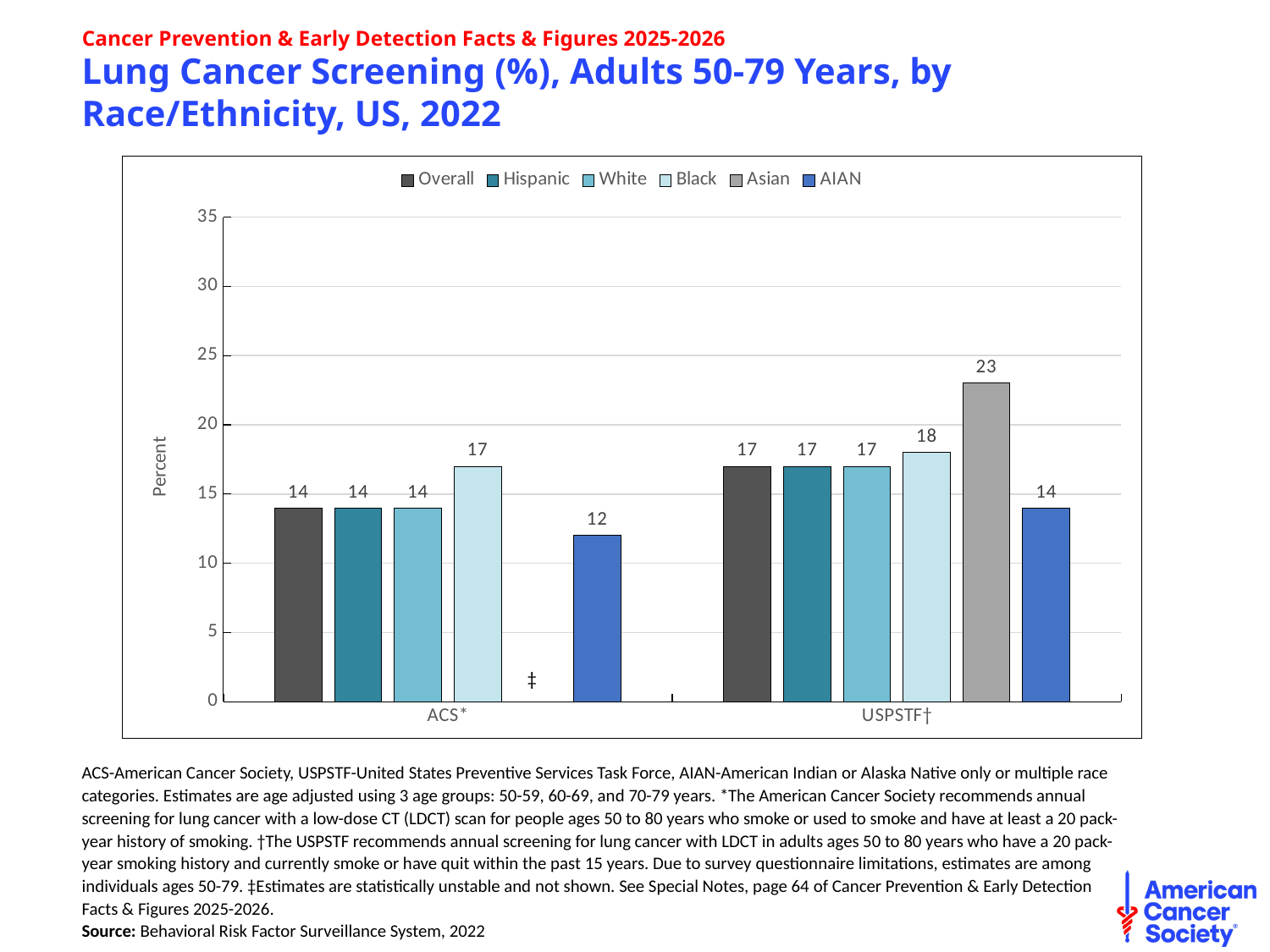
How many series does the legend list? 6 What is the label on the vertical axis of the chart? Percent What is the lung cancer screening percentage for Black adults under the USPSTF† criteria? 18 What is the value for Asian adults under the USPSTF† criteria? 23 Which race/ethnicity group has the lowest value under the ACS* criteria among the bars shown? AIAN Which race/ethnicity group has the highest value under the USPSTF† criteria? Asian Which series is not shown as a bar under the ACS* criteria because its estimate is statistically unstable? Asian What is the difference between the Asian and AIAN values under the USPSTF† criteria? 9 What kind of chart is shown on the slide? Bar chart What is the value for AIAN adults under the ACS* criteria? 12 Which is larger: the Black value under ACS* or the Black value under USPSTF†? USPSTF† What is the Overall value under the ACS* criteria? 14